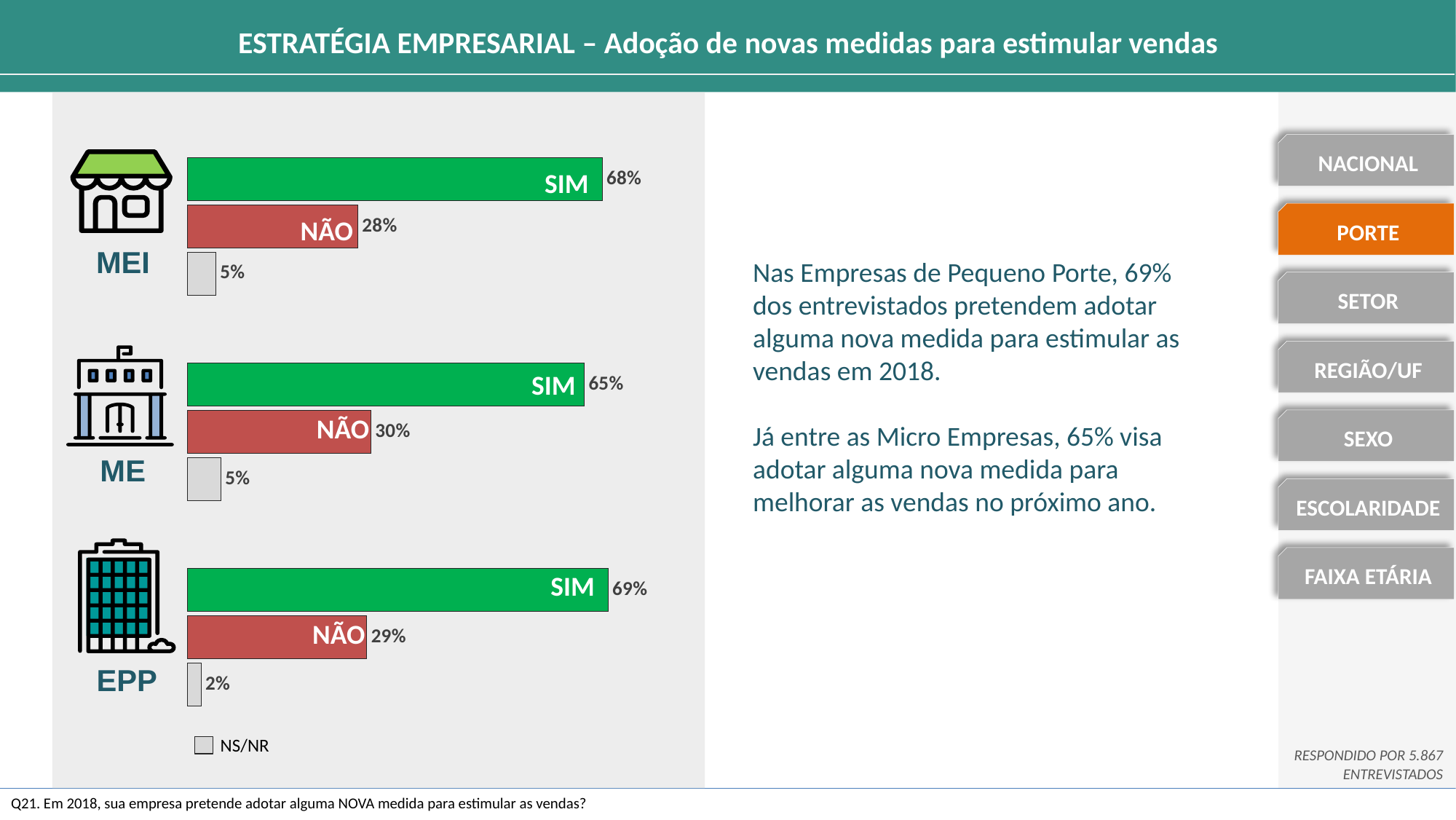
In the EPP chart, what is the difference between the SIM and NÃO values? 40% In the MEI chart, what is the difference between the SIM and NÃO values? 40% In the MEI chart, which response has the lowest value? NS/NR What type of chart is used for the MEI, ME and EPP data? Bar chart In the ME chart, which response has the highest value? SIM Which is larger: the SIM value in the EPP chart or the SIM value in the ME chart? EPP What label does the legend give to the grey bars? NS/NR In the MEI chart, what percentage answered SIM? 68% In the EPP chart, what is the value of the NS/NR bar? 2% In the ME chart, what percentage answered NÃO? 30% In the EPP chart, what percentage answered SIM? 69% How many response categories are shown in the ME chart? 3